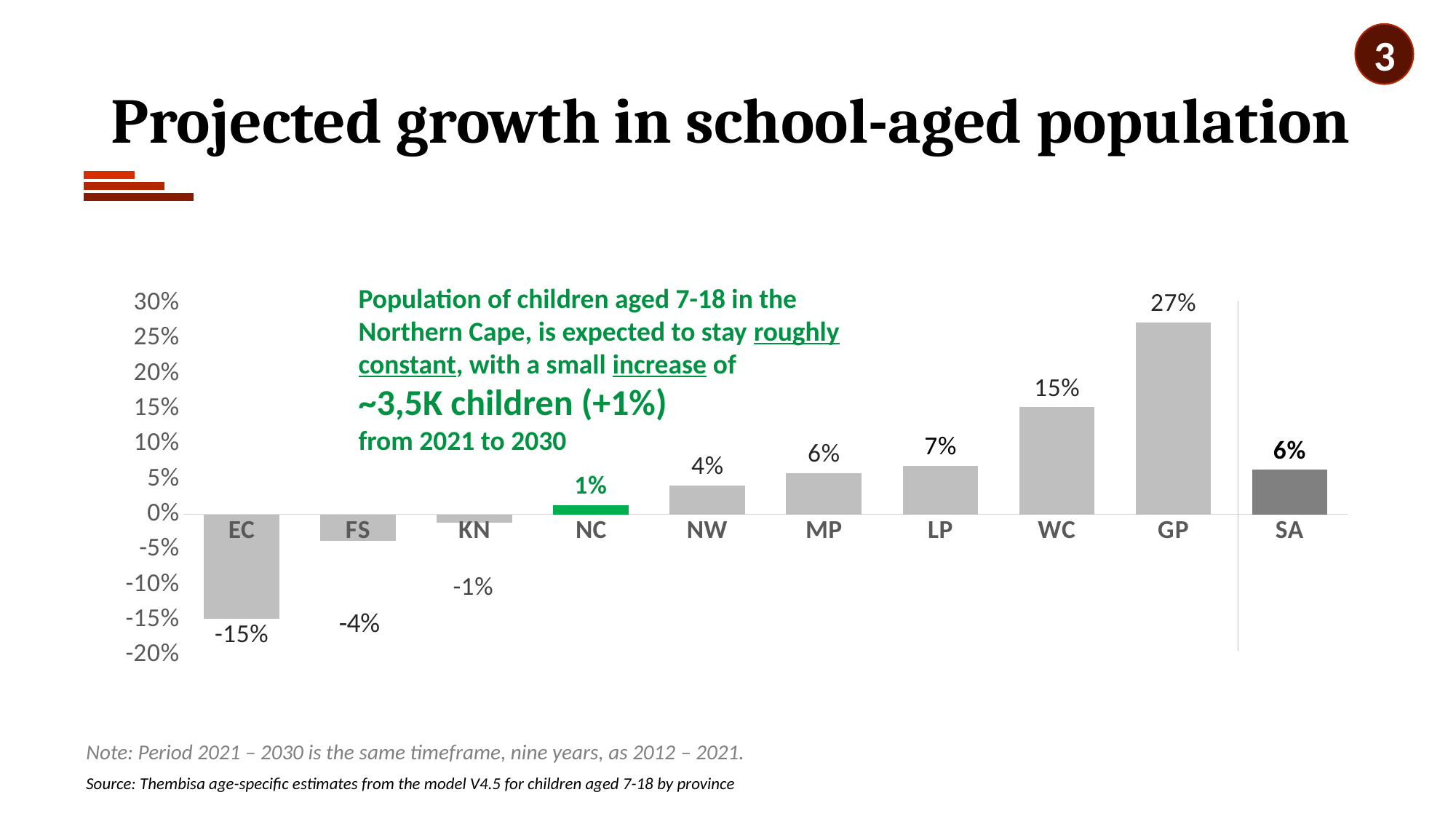
Which province has the lowest projected growth? EC How many categories are shown on the x axis? 10 What is the projected growth value for SA? 6% What is the difference between the values for GP and WC? 12% Which bar is coloured green? NC What is the projected growth value for GP? 27% What is the projected growth value for EC? -15% Which province has the highest projected growth? GP Is the value for WC greater or less than 10%? greater What is the projected growth value for NC? 1% Which has a larger projected growth, LP or MP? LP What kind of chart is shown on the slide? Bar chart